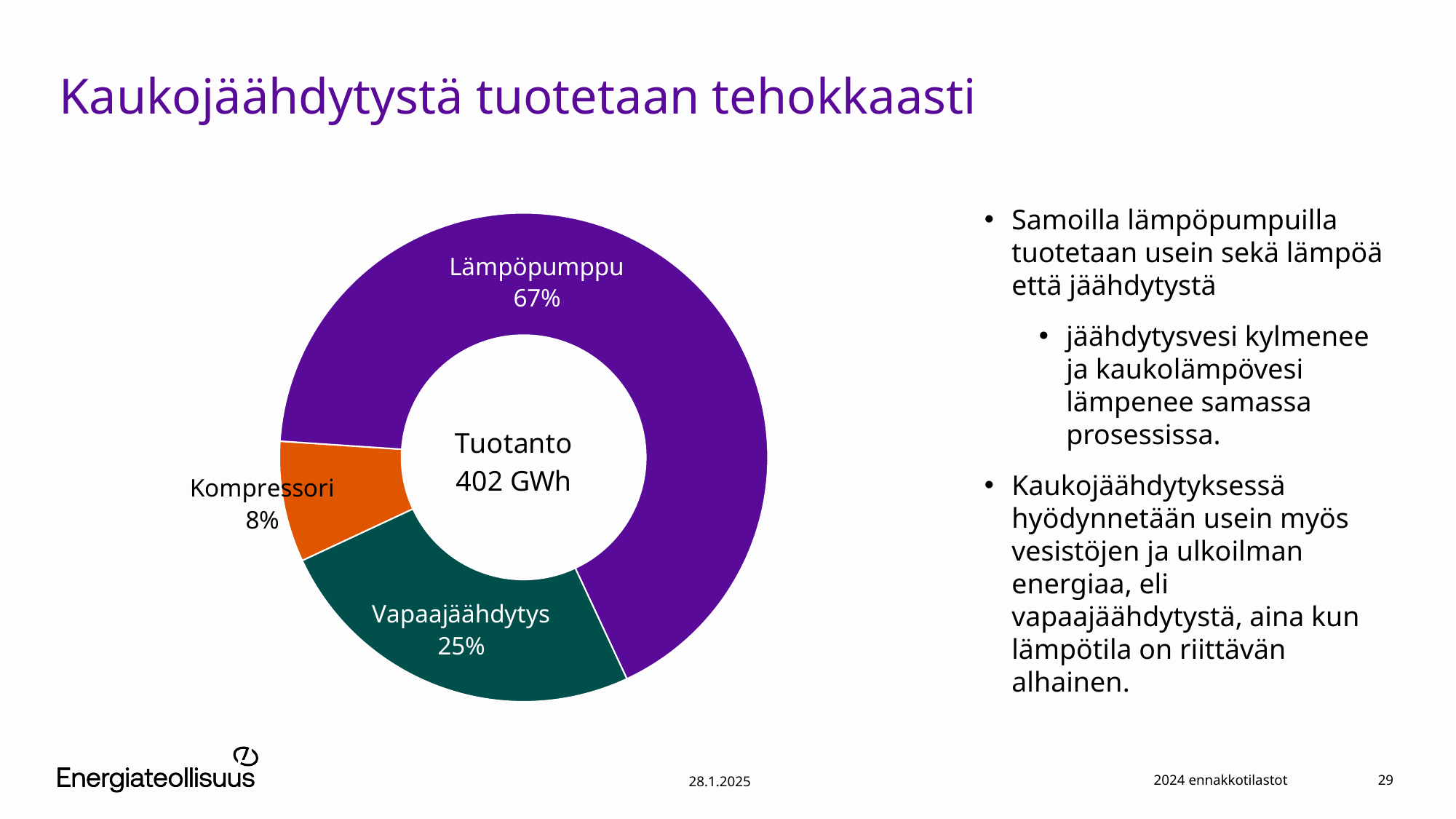
What kind of chart is shown on the slide? Doughnut (pie) chart What is the difference in percentage points between the Lämpöpumppu and Vapaajäähdytys shares? 42 How many categories are shown in the chart? 3 What total production value is shown in the centre of the chart? 402 GWh Which category has the largest share in the chart? Lämpöpumppu Which has a larger share, Vapaajäähdytys or Kompressori? Vapaajäähdytys What is the difference in percentage points between the Vapaajäähdytys and Kompressori shares? 17 What share of the chart does Kompressori account for? 8% What share of the chart does Lämpöpumppu account for? 67% What colour is the Kompressori segment of the chart? Orange Which category has the smallest share in the chart? Kompressori What share of the chart does Vapaajäähdytys account for? 25%